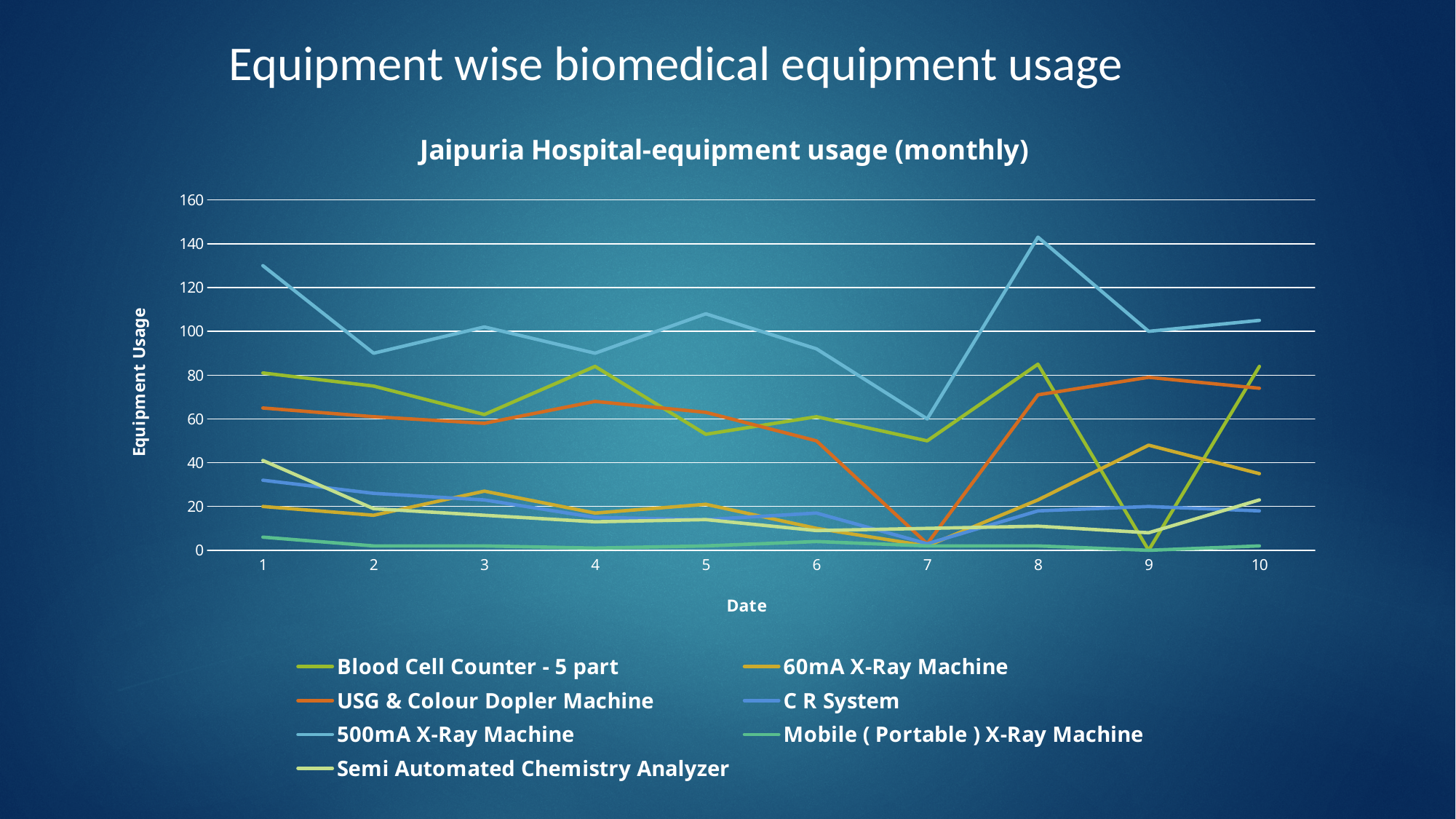
Is the value for the 500mA X-Ray Machine at date 8 greater or less than 120? greater At date 1, which is larger: Blood Cell Counter - 5 part or USG & Colour Dopler Machine? Blood Cell Counter - 5 part At which date does the 500mA X-Ray Machine have its lowest usage? 7 How many series does the legend list? 7 What is the title of the chart? Jaipuria Hospital-equipment usage (monthly) Is the value for the USG & Colour Dopler Machine at date 7 greater or less than 20? less How many dates are plotted along the x axis? 10 Does the usage of the 500mA X-Ray Machine rise or fall from date 1 to date 2? fall What kind of chart is shown on the slide? line chart Which series has the highest usage at date 1? 500mA X-Ray Machine What is the label on the vertical axis? Equipment Usage At which date does the 500mA X-Ray Machine reach its highest usage? 8